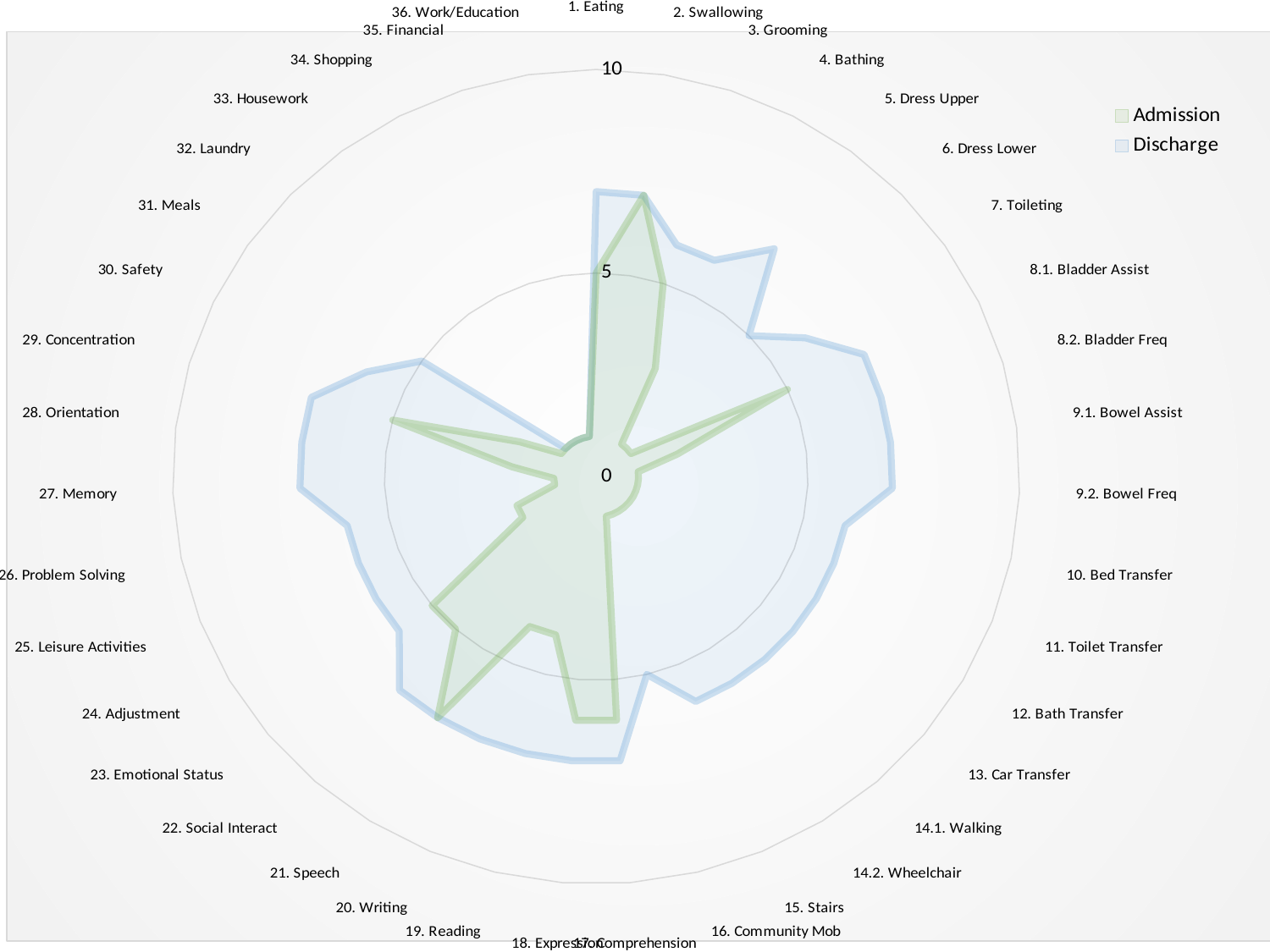
Is the Discharge value for 18. Expression greater or less than 5? greater Is the Admission value for 27. Memory greater or less than 5? less Which colour represents the Discharge series? Blue How many series does the legend list? 2 What are the two series named in the legend? Admission and Discharge Is the Admission value for 9.2 Bowel Freq greater or less than 5? less For 9.2 Bowel Freq, which series has the larger value, Admission or Discharge? Discharge What is the maximum value shown on the radial axis? 10 For 27. Memory, which series has the larger value, Admission or Discharge? Discharge What kind of chart is shown on the slide? Radar chart